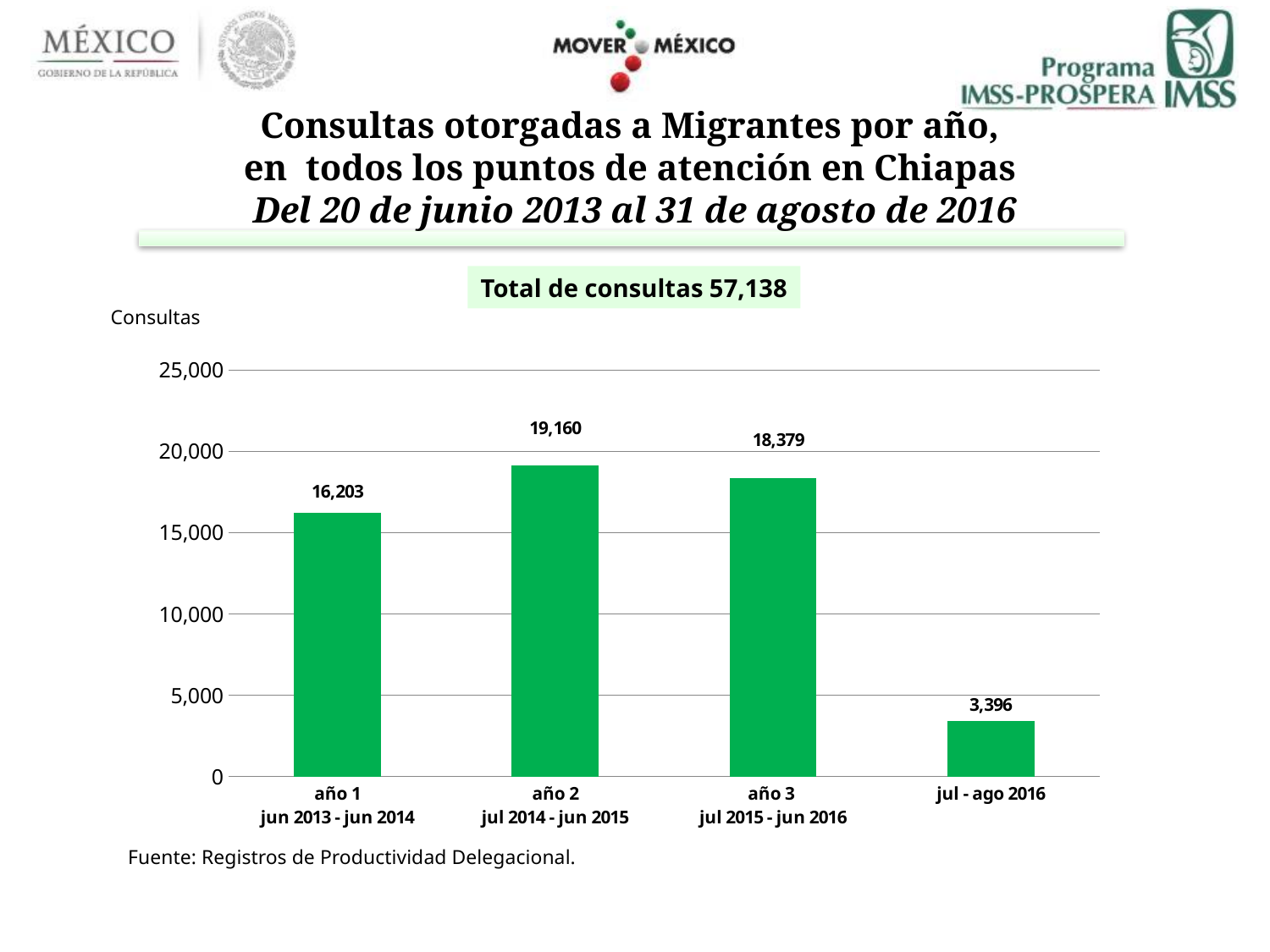
What is the value for año 3 (jul 2015 - jun 2016)? 18,379 How many consultas were given in año 1 (jun 2013 - jun 2014)? 16,203 What is the value for año 2 (jul 2014 - jun 2015)? 19,160 What total number of consultas is stated above the chart? 57,138 How many consultas were given in jul - ago 2016? 3,396 What is the difference between the consultas in año 2 and año 3? 781 Which period has the lowest number of consultas? jul - ago 2016 Which period has the highest number of consultas? año 2 (jul 2014 - jun 2015) What type of chart is shown on the slide? bar chart How many bars are shown in the chart? 4 What is the difference between the consultas in año 1 and año 2? 2,957 Which is larger, the value for año 1 or the value for año 3? año 3